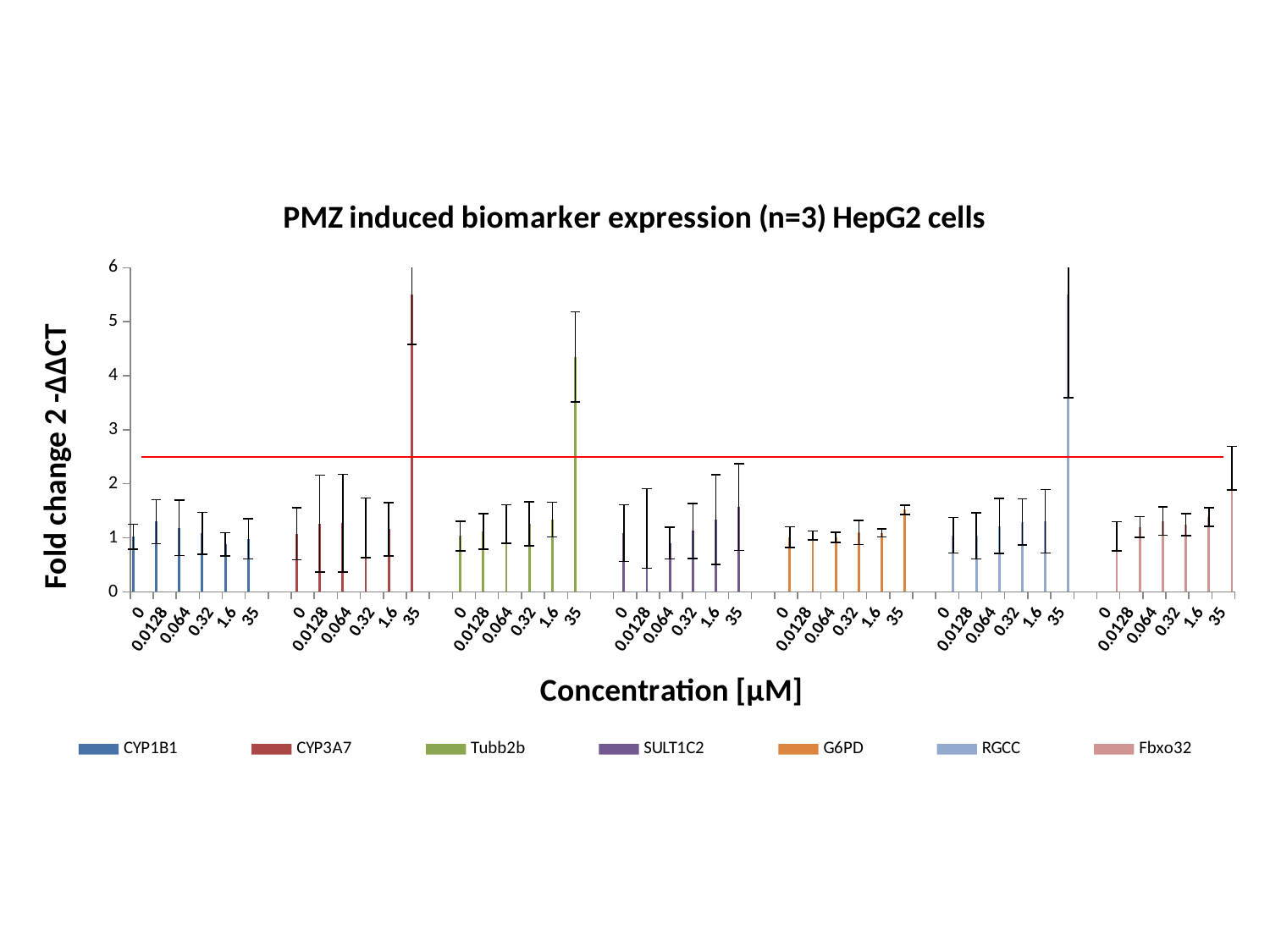
What is the title of the chart? PMZ induced biomarker expression (n=3) HepG2 cells How many series does the legend list? 7 How many concentration levels are plotted for each series? 6 Is the value for G6PD at 35 µM greater or less than 2? less Which is larger, the value for RGCC at 35 µM or the value for SULT1C2 at 35 µM? RGCC at 35 µM Is the value for CYP1B1 at 0 µM greater or less than 2? less Is the value for Tubb2b at 35 µM greater or less than 3? greater At which concentration does CYP3A7 reach its highest value? 35 What kind of chart is shown on the slide? bar chart What is the label of the x axis? Concentration [µM]